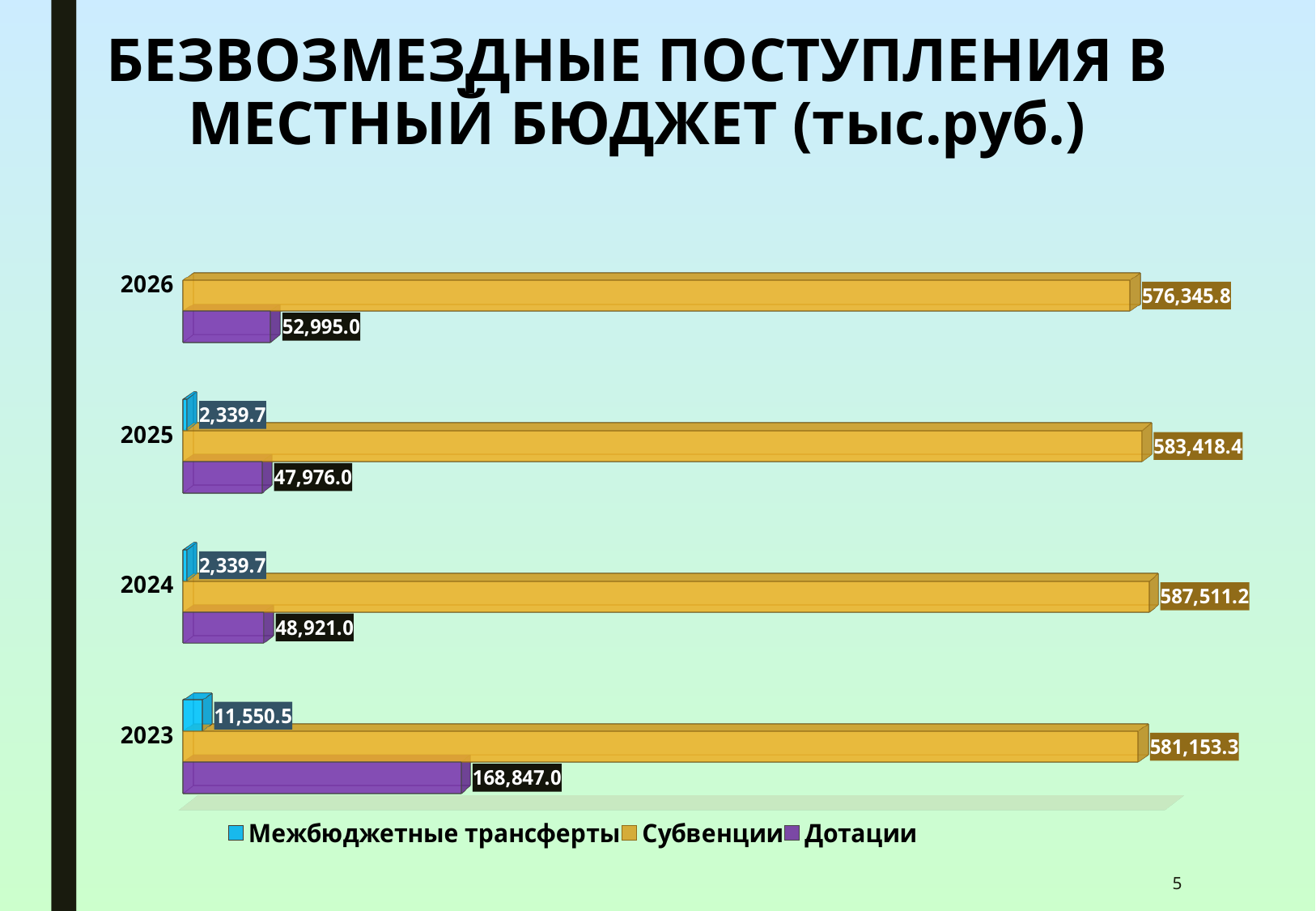
In which year is the value of Дотации the lowest? 2025 In which year is the value of Субвенции the highest? 2024 How many years are shown on the chart? 4 What is the difference between the Дотации values for 2026 and 2025? 5,019.0 Which year has the larger Субвенции value, 2025 or 2023? 2025 What is the value of Субвенции for 2024? 587,511.2 How many series does the legend list? 3 What is the difference between the Межбюджетные трансферты values for 2023 and 2024? 9,210.8 What is the value of Дотации for 2023? 168,847.0 What is the value of Дотации for 2026? 52,995.0 What is the value of Межбюджетные трансферты for 2023? 11,550.5 What kind of chart is shown on the slide? Bar chart